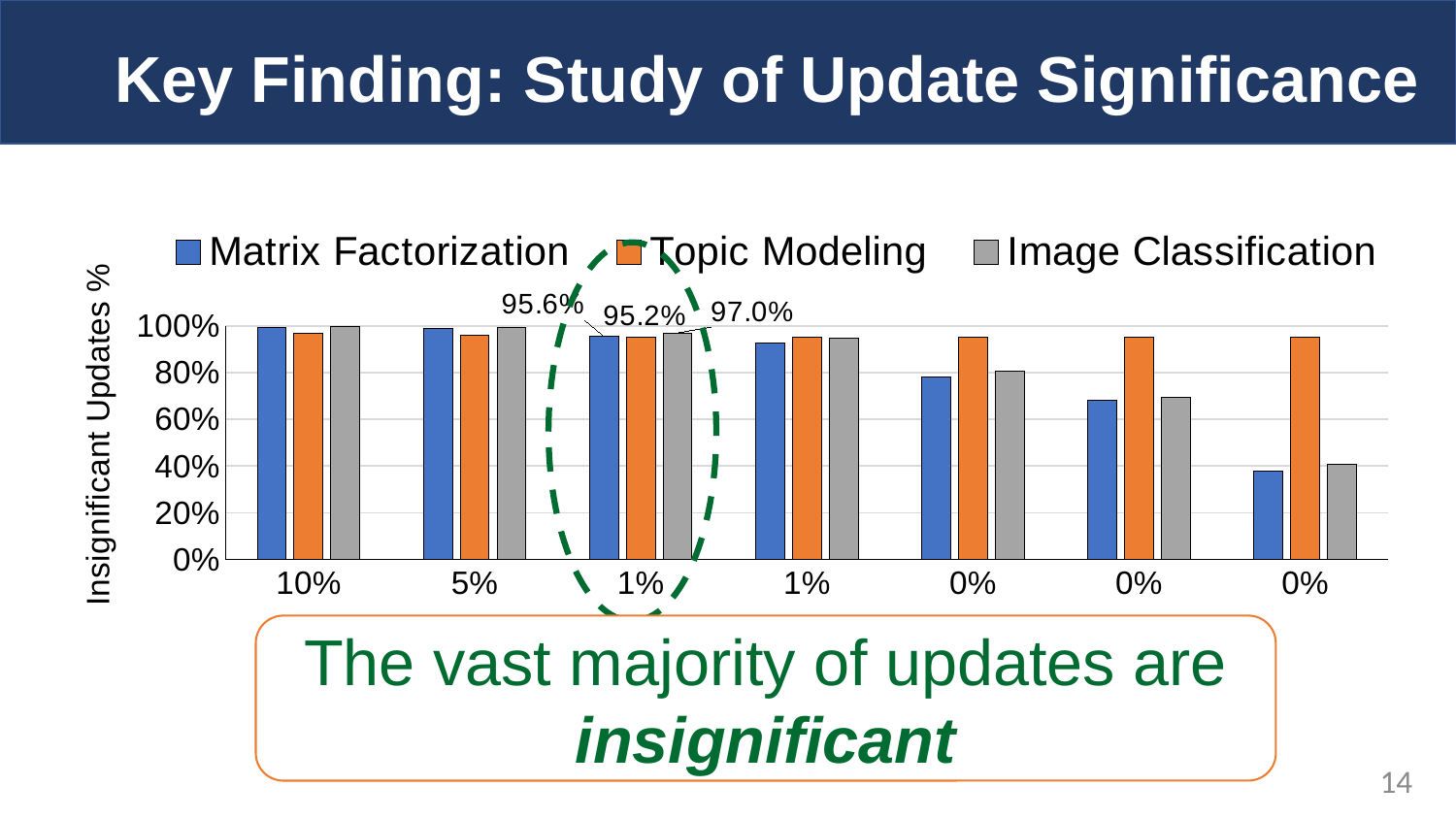
Do the Matrix Factorization values rise or fall moving from left to right along the x axis? fall What is the labelled value for Image Classification in the circled third group (1%)? 97.0% What is the label on the y axis? Insignificant Updates % In the last group on the right (0%), which is larger: Matrix Factorization or Topic Modeling? Topic Modeling What kind of chart is shown on the slide? bar chart What is the labelled value for Matrix Factorization in the circled third group (1%)? 95.6% In the last group on the right (0%), is the value for Matrix Factorization greater or less than 60%? less How many category groups are shown along the x axis? 7 In the circled third group (1%), which series has the highest labelled value? Image Classification In the circled third group (1%), what is the difference between the Image Classification value and the Topic Modeling value? 1.8% How many series does the legend list? 3 What is the labelled value for Topic Modeling in the circled third group (1%)? 95.2%